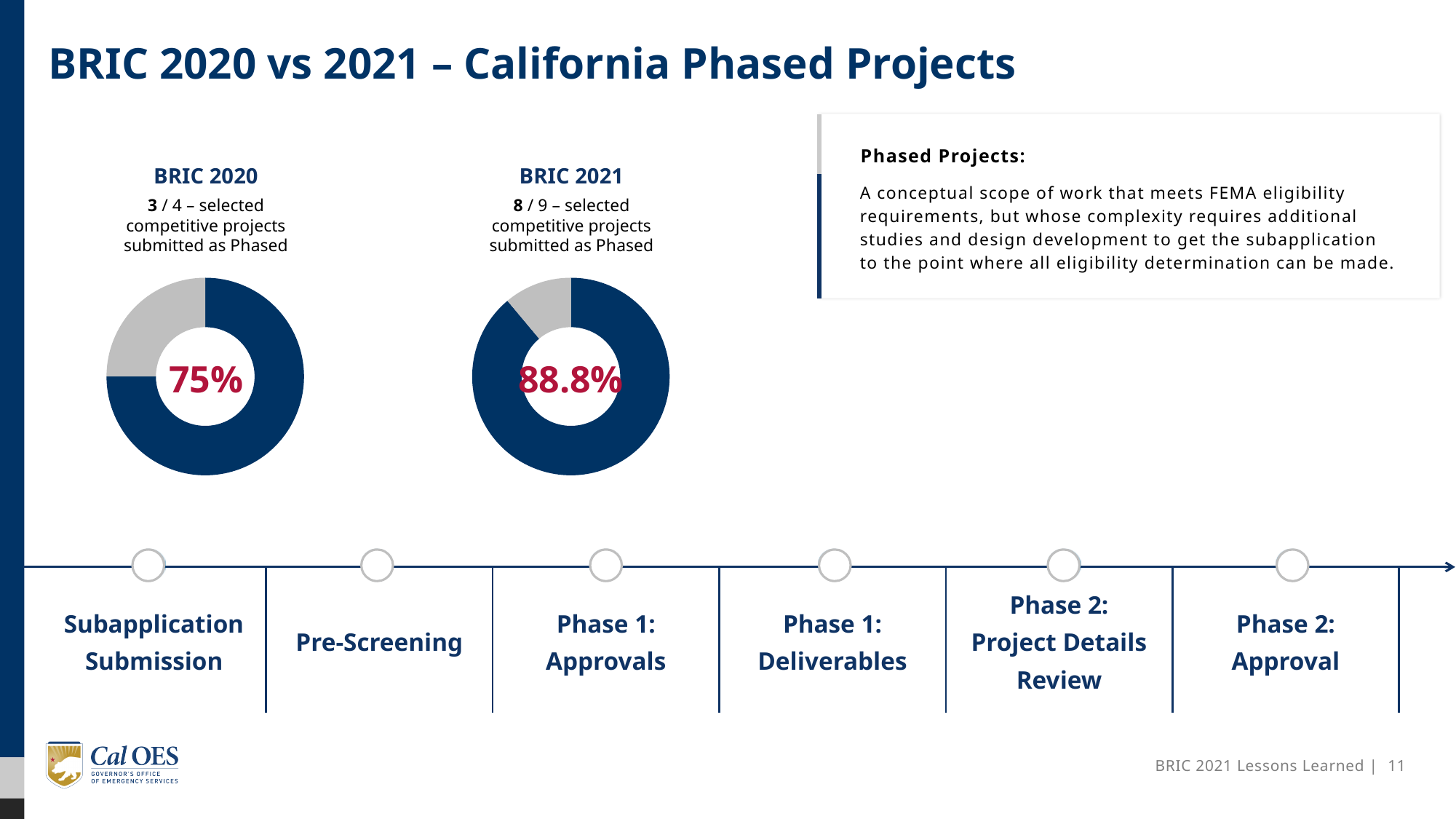
By how many percentage points does the BRIC 2021 phased share exceed the BRIC 2020 phased share? 13.8 How many donut charts are shown on the slide? 2 What percentage is shown in the centre of the BRIC 2020 donut chart? 75% What type of chart is used to show the BRIC 2020 and BRIC 2021 phased project shares? Donut chart Which chart shows the higher share of projects submitted as Phased, BRIC 2020 or BRIC 2021? BRIC 2021 What percentage is shown in the centre of the BRIC 2021 donut chart? 88.8% According to the BRIC 2020 chart, how many selected competitive projects were submitted as Phased? 3 What is the title of the slide containing the two donut charts? BRIC 2020 vs 2021 – California Phased Projects According to the BRIC 2021 chart, how many selected competitive projects were there in total? 9 What colour is the segment representing projects submitted as Phased in both donut charts? Dark blue In the BRIC 2020 chart, what share of the donut does the dark blue segment represent? 75% According to the BRIC 2021 chart, how many selected competitive projects were submitted as Phased? 8